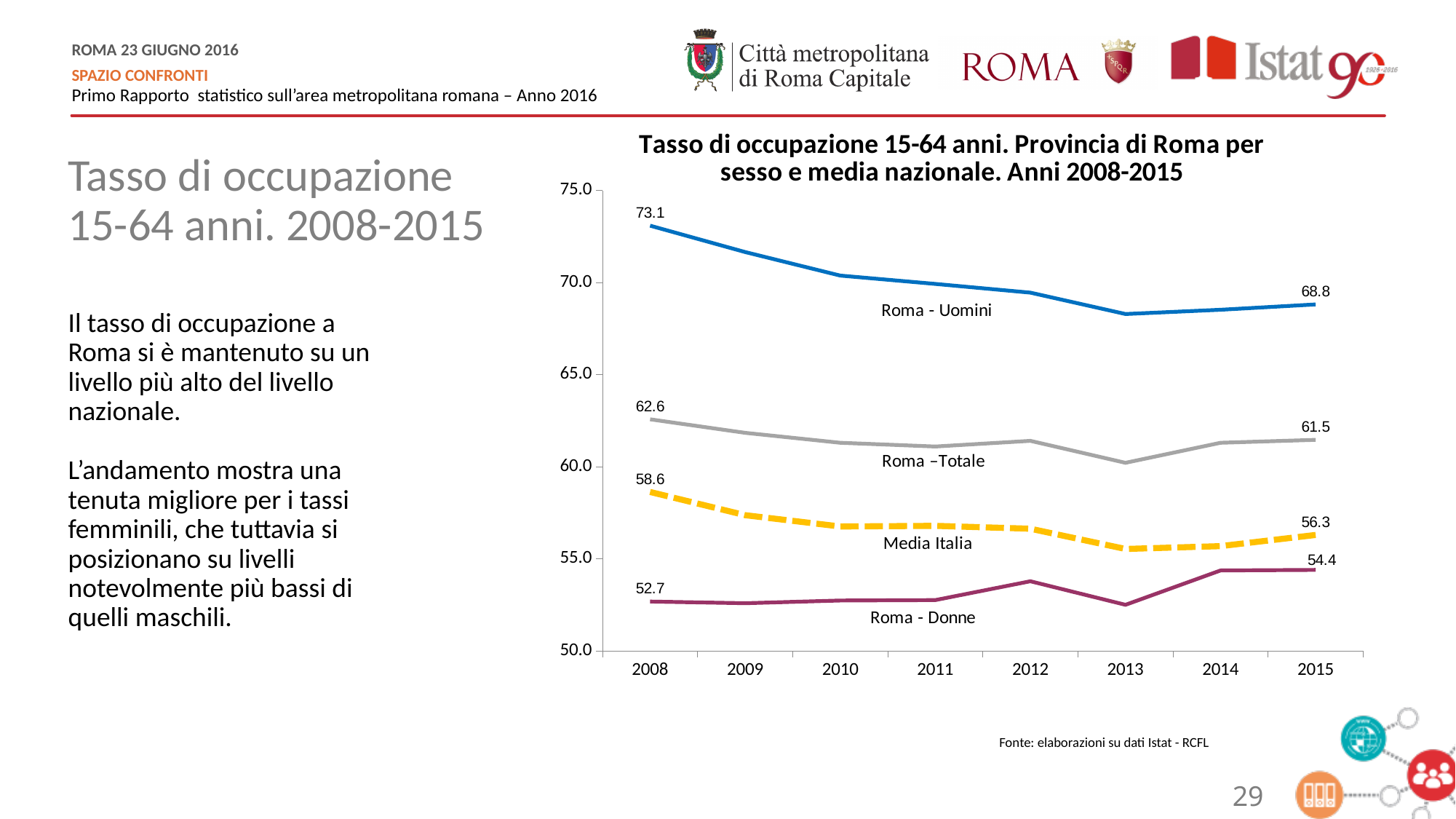
Is the value for Roma - Totale in 2013 greater or less than 65.0? less What is the value for Media Italia in 2008? 58.6 What is the difference between the Roma - Uomini value in 2008 and in 2015? 4.3 What is the value for Roma - Uomini in 2008? 73.1 What is the value for Roma - Totale in 2015? 61.5 Which series has the highest value in 2015? Roma - Uomini What type of chart is shown on the slide? line chart How many years are shown on the x axis? 8 How many series are plotted in the chart? 4 What is the value for Roma - Donne in 2015? 54.4 What is the value for Roma - Uomini in 2015? 68.8 Which series has the lowest value in 2008? Roma - Donne